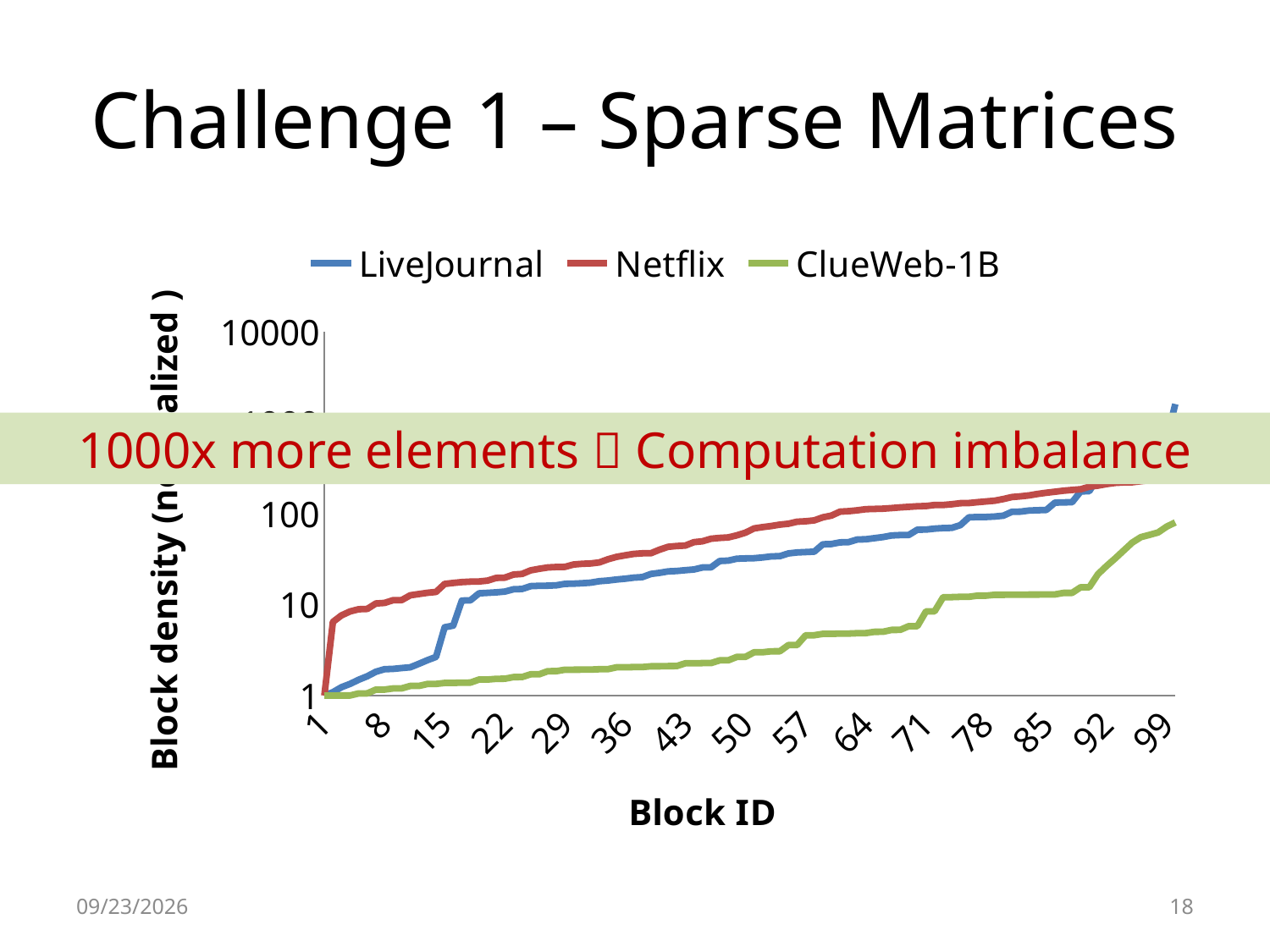
What kind of chart is shown on the slide? line chart Is the value for ClueWeb-1B at Block ID 50 greater or less than 10? less Do the values of the Netflix series rise or fall as Block ID increases? rise Which series has the lowest values across the Block IDs? ClueWeb-1B What is the title of the x axis? Block ID Do the values of the ClueWeb-1B series rise or fall as Block ID increases? rise How many series does the legend list? 3 Is the value for LiveJournal at Block ID 8 greater or less than 10? less Is the value for Netflix at Block ID 50 greater or less than 10? greater Which series are listed in the legend? LiveJournal, Netflix, ClueWeb-1B At Block ID 50, which series has the larger value, Netflix or LiveJournal? Netflix